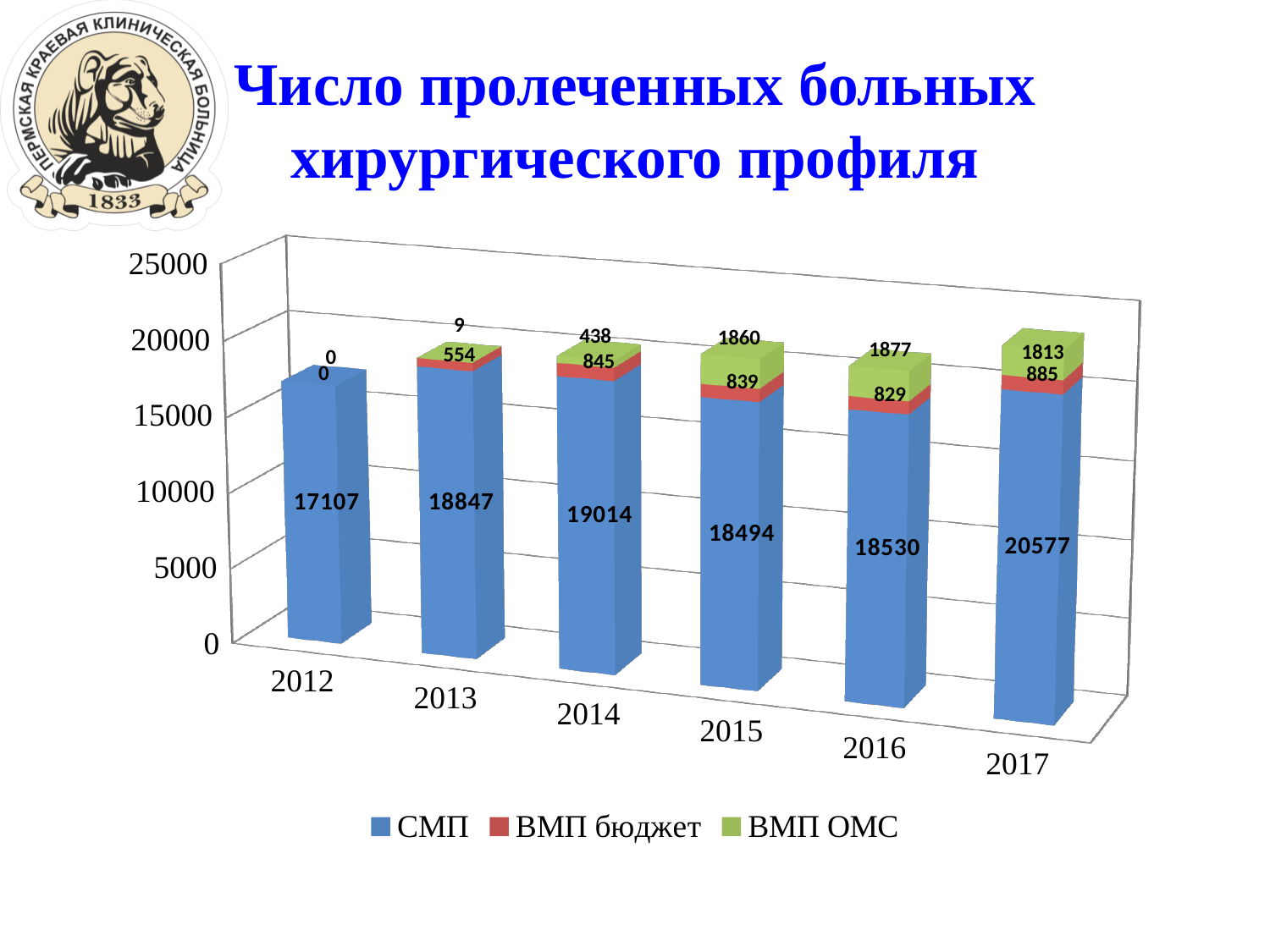
Which year has the highest СМП value? 2017 Which year has the lowest СМП value? 2012 How many series does the legend list? 3 How many years are shown on the x axis? 6 What is the total of the stacked bar for 2017? 23275 What kind of chart is shown on the slide? stacked bar chart What is the value of ВМП ОМС for 2015? 1860 What is the title of the chart? Число пролеченных больных хирургического профиля What is the value of ВМП бюджет for 2013? 554 What is the value of СМП for 2017? 20577 What is the difference between the СМП values for 2017 and 2016? 2047 Which is larger, the ВМП ОМС value for 2016 or for 2017? 2016